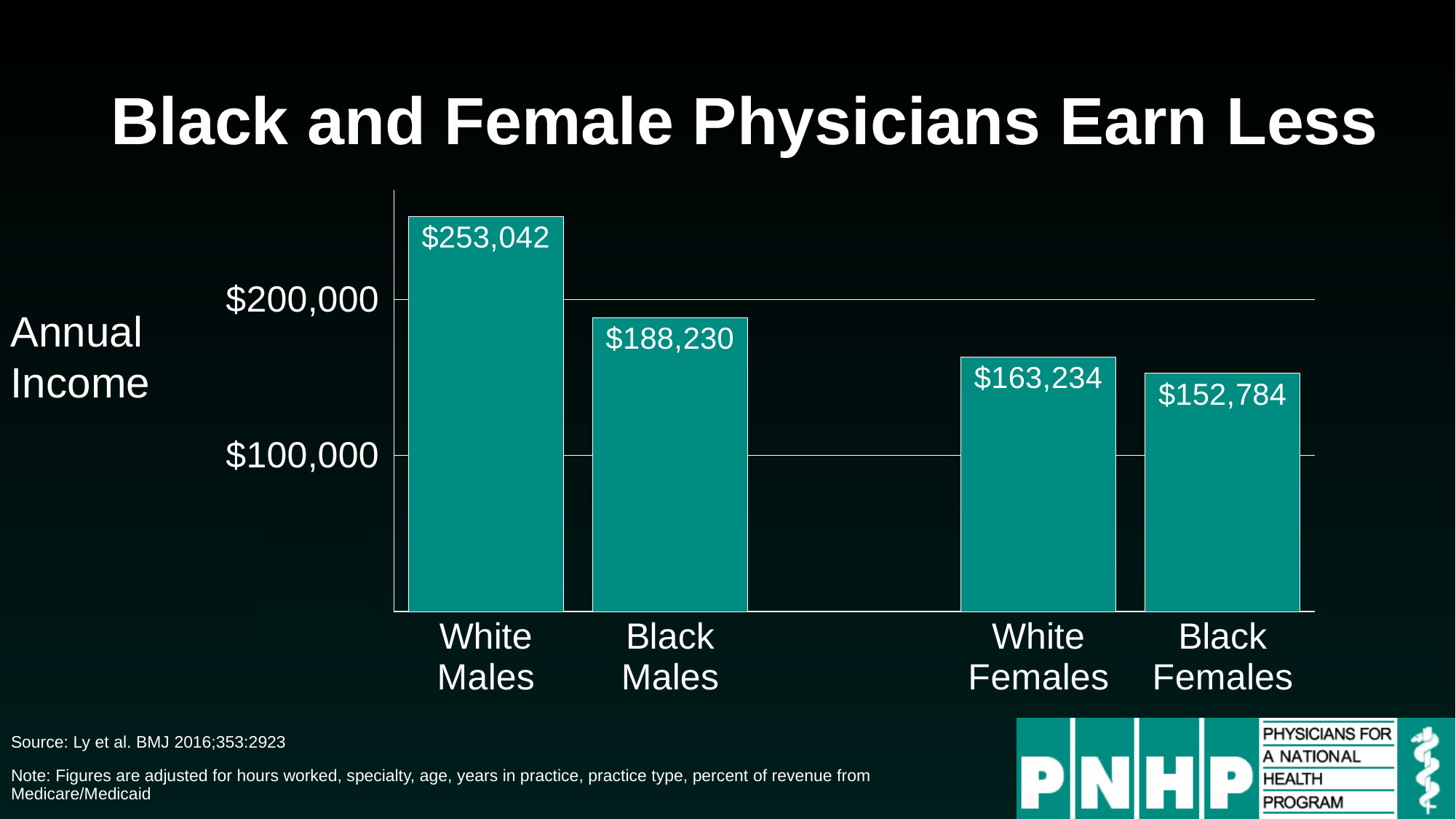
Which category has the lowest annual income? Black Females What is the title of the slide? Black and Female Physicians Earn Less What is the annual income for White Females? $163,234 What is the difference in annual income between White Males and Black Males? $64,812 Which category has the highest annual income? White Males What kind of chart is shown on the slide? bar chart How many categories are shown in the chart? 4 What is the difference in annual income between White Females and Black Females? $10,450 Is the annual income for Black Males greater or less than $200,000? less Which has a higher annual income, Black Males or White Females? Black Males What is the annual income for Black Females? $152,784 What is the annual income for White Males? $253,042